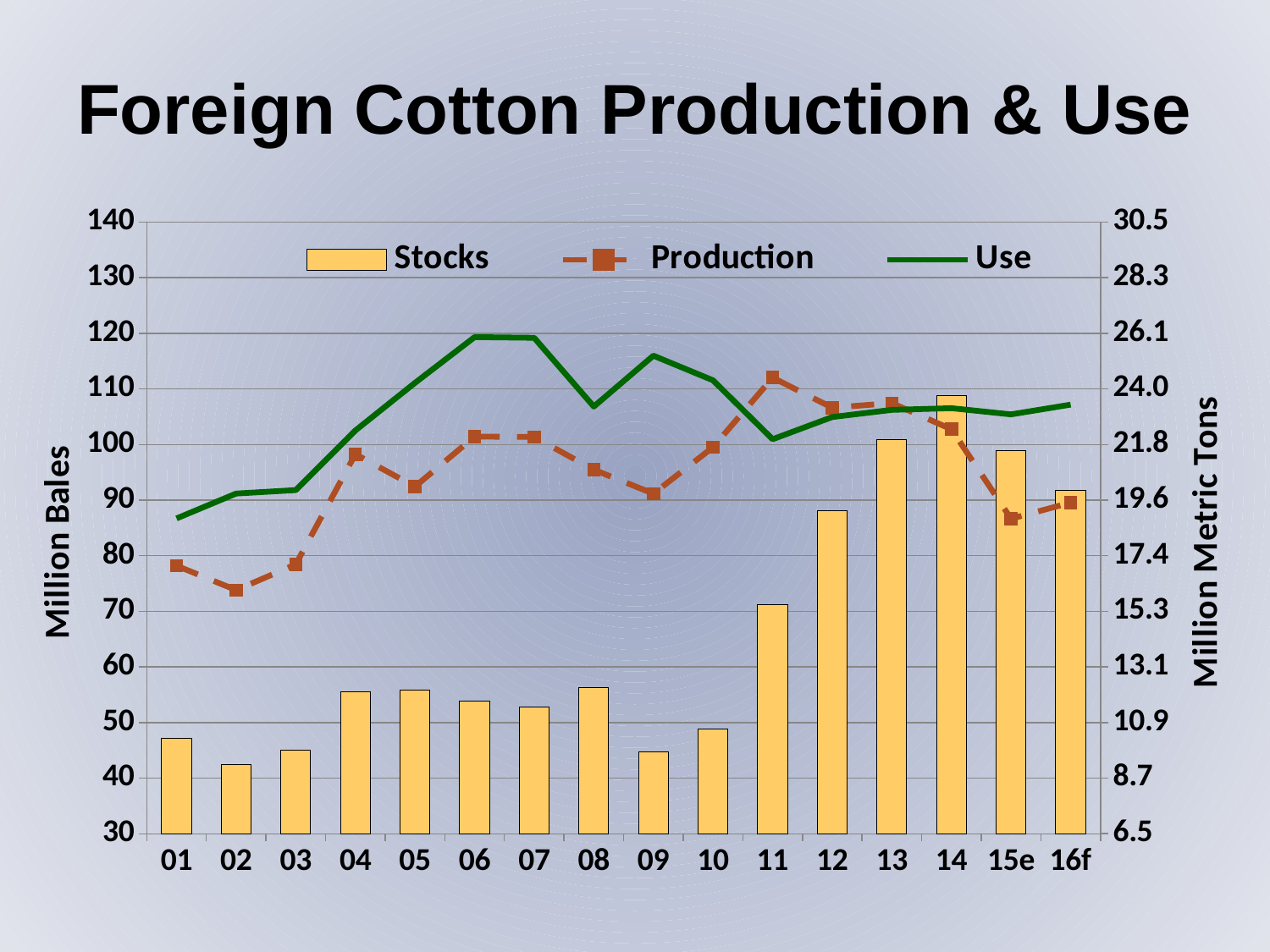
In which year are Stocks lowest? 02 How many series does the legend list? 3 What is the title of the chart? Foreign Cotton Production & Use Is the Stocks value for 02 greater or less than 50? less Is the Stocks value for 14 greater or less than 100? greater Do Stocks rise or fall from 11 to 14? rise What kind of chart is this? Combined bar and line chart Is the Production value for 02 greater or less than 80 on the left axis scale? less In which year are Stocks highest? 14 Which year has larger Stocks, 12 or 13? 13 How many categories are shown on the x axis? 16 Which series is drawn as bars? Stocks